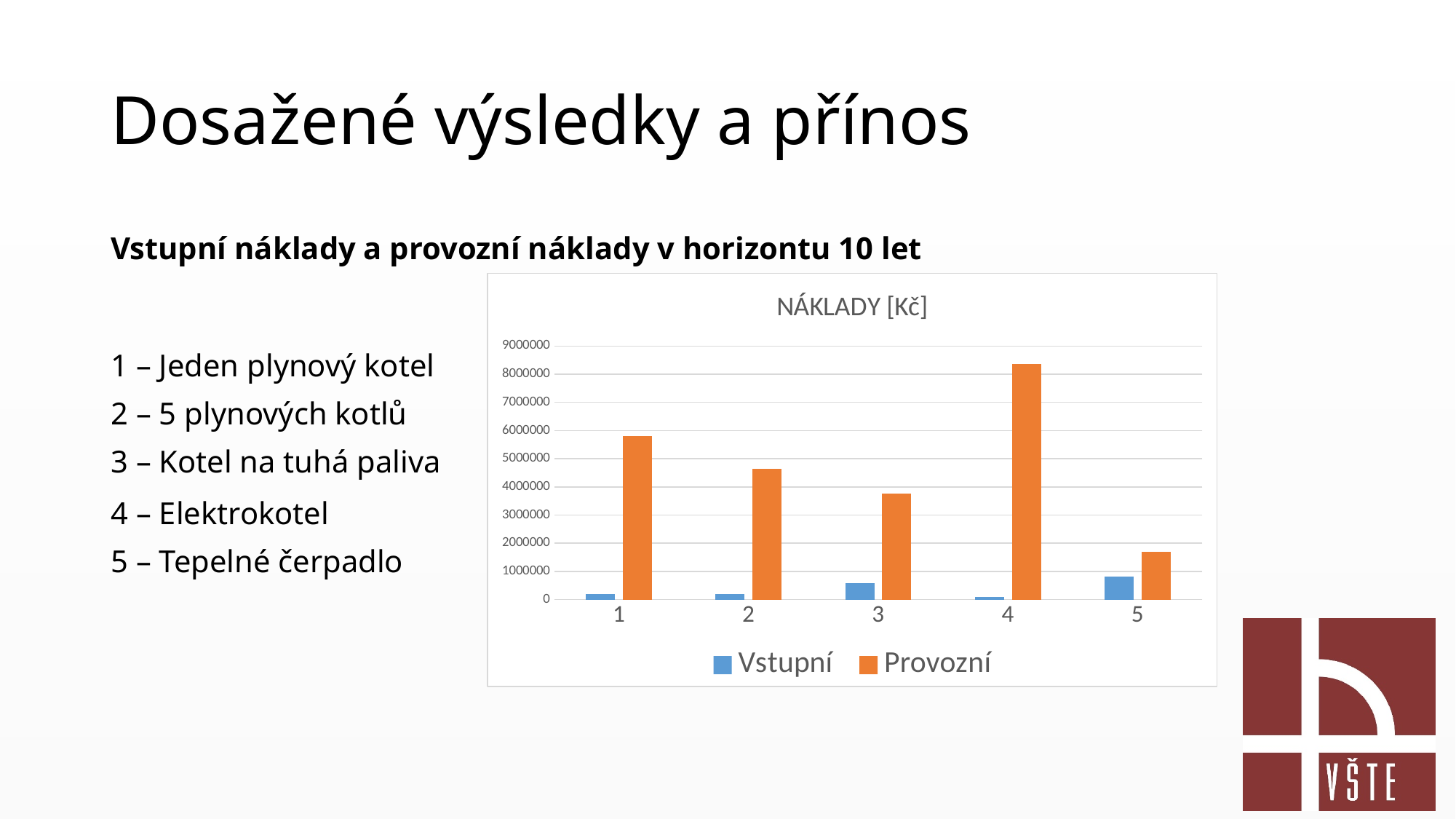
Is the Provozní value for category 3 greater or less than 4000000? less How many categories are shown on the x axis of the chart? 5 Which category has the lowest Provozní value? 5 Which category has the highest Vstupní value? 5 Which category has the highest Provozní value? 4 What is the title of the chart? NÁKLADY [Kč] Is the Provozní value for category 4 greater or less than 8000000? greater How many series does the legend of the chart list? 2 Is the Provozní value for category 1 greater or less than 6000000? less What kind of chart is shown on the slide? bar chart Which is larger, the Provozní value for category 2 or for category 3? category 2